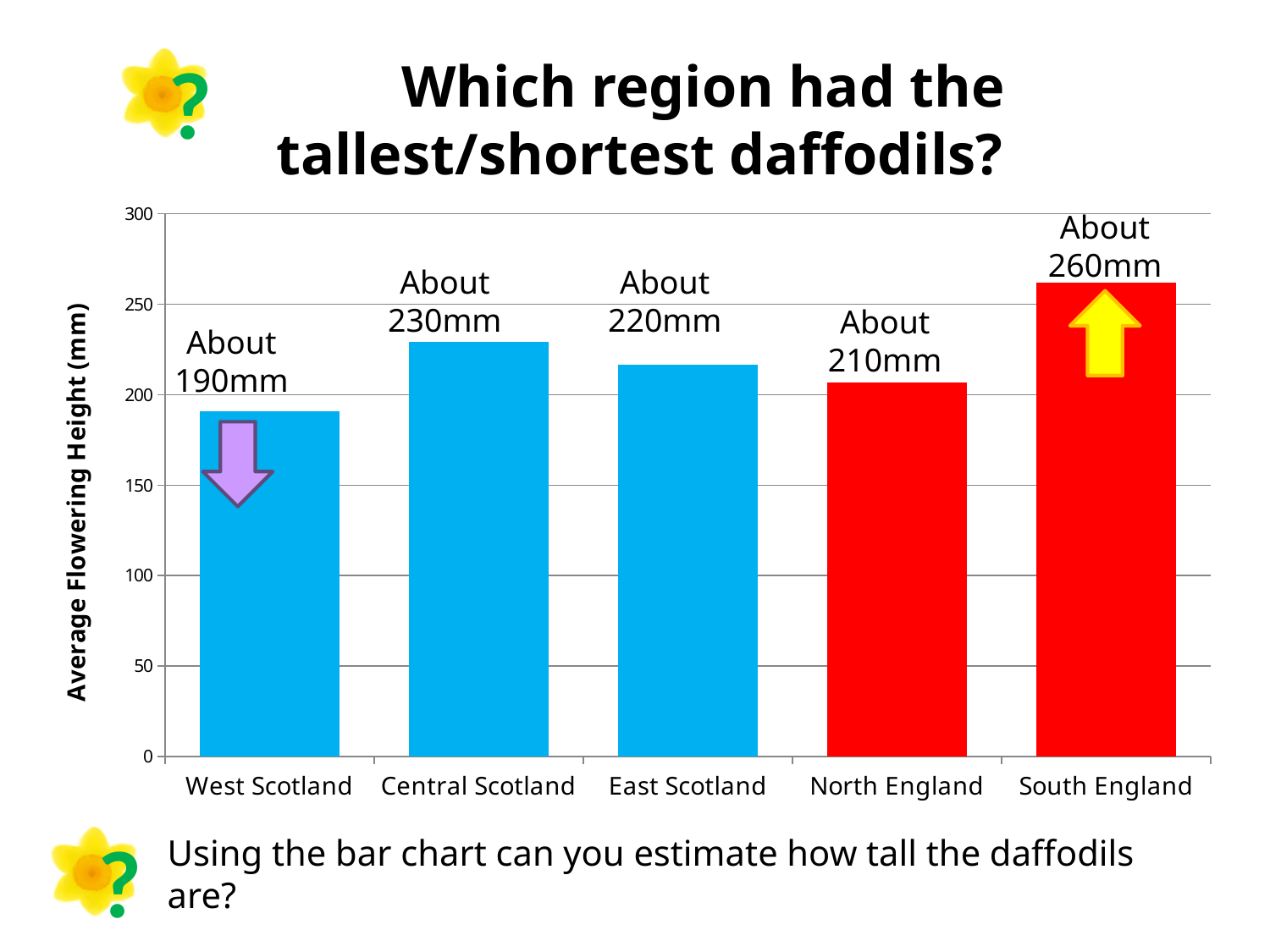
Which regions' bars are coloured red in the chart? North England and South England How many regions are shown on the x axis of the chart? 5 Is the value for Central Scotland greater or less than 200? greater Is the value for South England greater or less than 250? greater What is the title of the vertical axis of the chart? Average Flowering Height (mm) Which has the larger value, South England or East Scotland? South England Is the value for North England greater or less than 250? less Which region has the shortest bar in the chart? West Scotland What kind of chart is shown on the slide? bar chart Which region has the tallest bar in the chart? South England Which has the larger value, Central Scotland or North England? Central Scotland